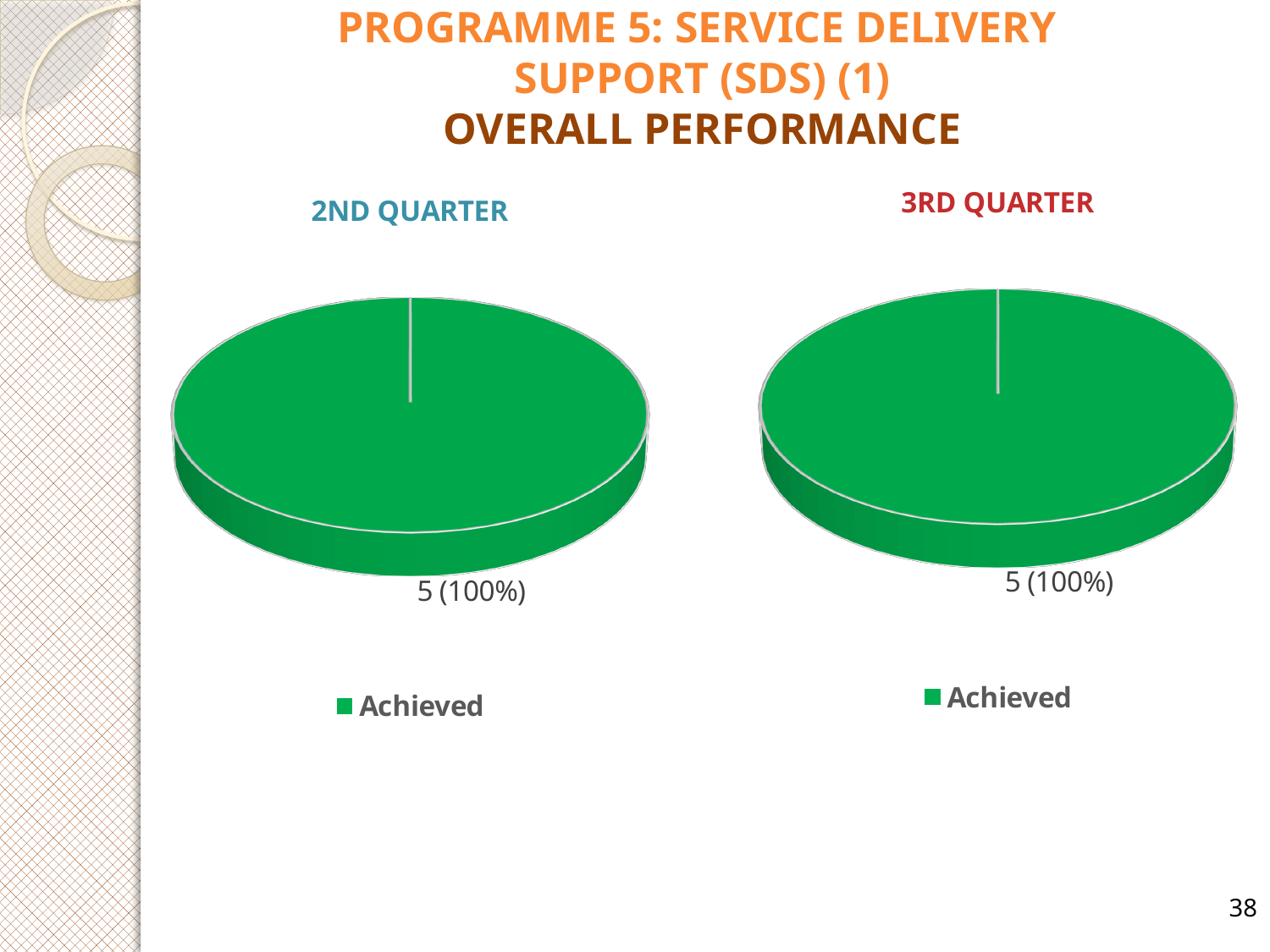
In the 3RD QUARTER chart, what share of the pie does the Achieved slice take? 100% In the 2ND QUARTER chart, what share of the pie does the Achieved slice take? 100% In the 3RD QUARTER chart, what is the data label shown for the Achieved slice? 5 (100%) What kind of chart is the 2ND QUARTER chart? Pie chart In the 2ND QUARTER chart, what is the data label shown for the Achieved slice? 5 (100%) What is the difference between the Achieved count in the 3RD QUARTER chart and the 2ND QUARTER chart? 0 How many entries does the legend of the 2ND QUARTER chart list? 1 What colour is the Achieved slice in the 2ND QUARTER chart? Green How many slices does the 3RD QUARTER pie chart have? 1 What is the legend entry shown for the 3RD QUARTER chart? Achieved What kind of chart is the 3RD QUARTER chart? Pie chart